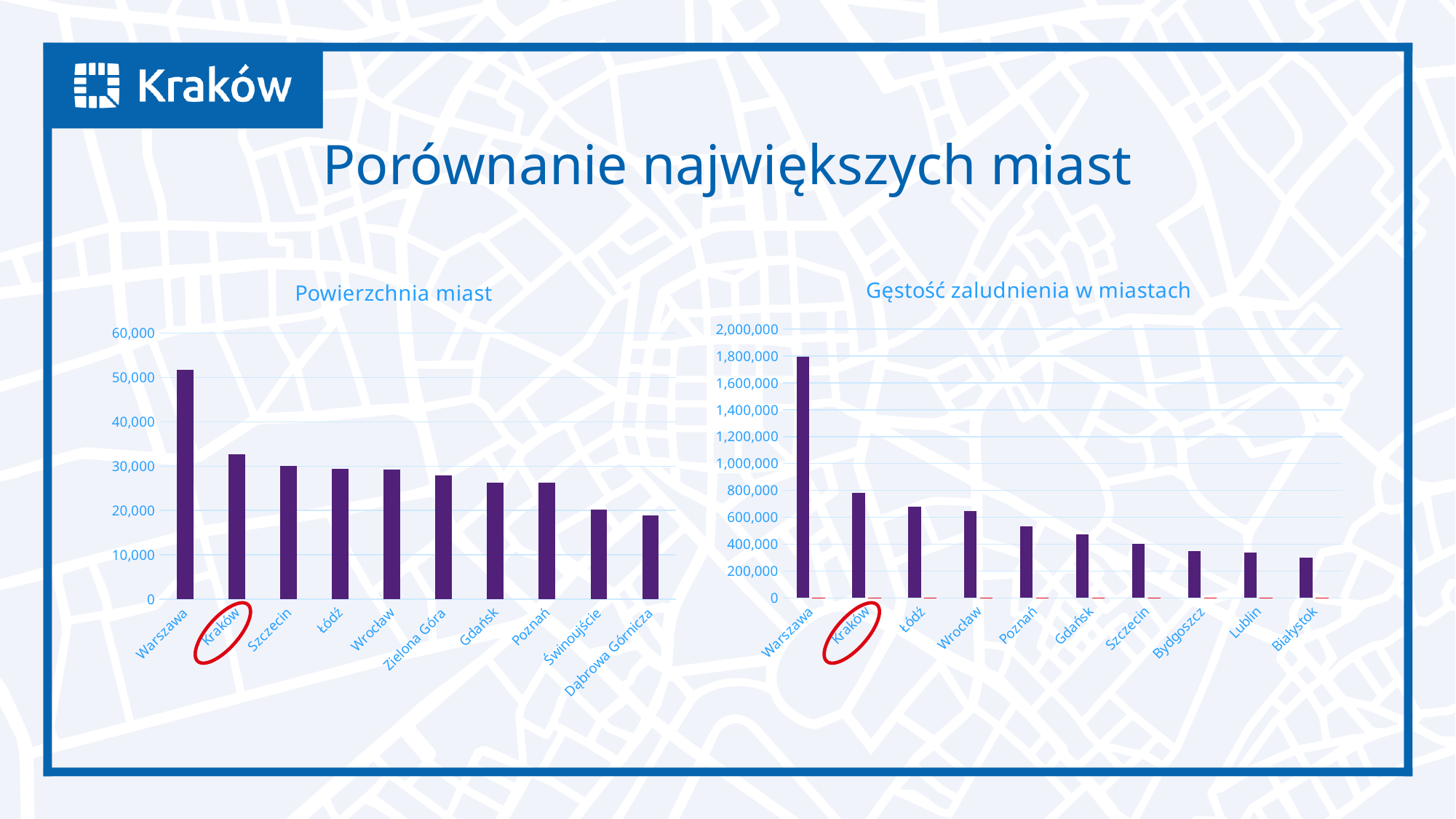
What kind of chart is the 'Powierzchnia miast' chart? bar chart On the 'Powierzchnia miast' chart, is the value for Kraków greater or less than 30,000? greater On the 'Gęstość zaludnienia w miastach' chart, is the value for Kraków greater or less than 600,000? greater On the 'Powierzchnia miast' chart, which city has the highest value? Warszawa On the 'Gęstość zaludnienia w miastach' chart, is the value for Warszawa greater or less than 1,600,000? greater How many cities are shown on the 'Gęstość zaludnienia w miastach' chart? 10 On the 'Gęstość zaludnienia w miastach' chart, which city has the highest value? Warszawa On the 'Gęstość zaludnienia w miastach' chart, do the values rise or fall from left to right? fall How many cities are shown on the 'Powierzchnia miast' chart? 10 On the 'Gęstość zaludnienia w miastach' chart, which is larger, the value for Kraków or the value for Łódź? Kraków On the 'Gęstość zaludnienia w miastach' chart, which city has the lowest value? Białystok